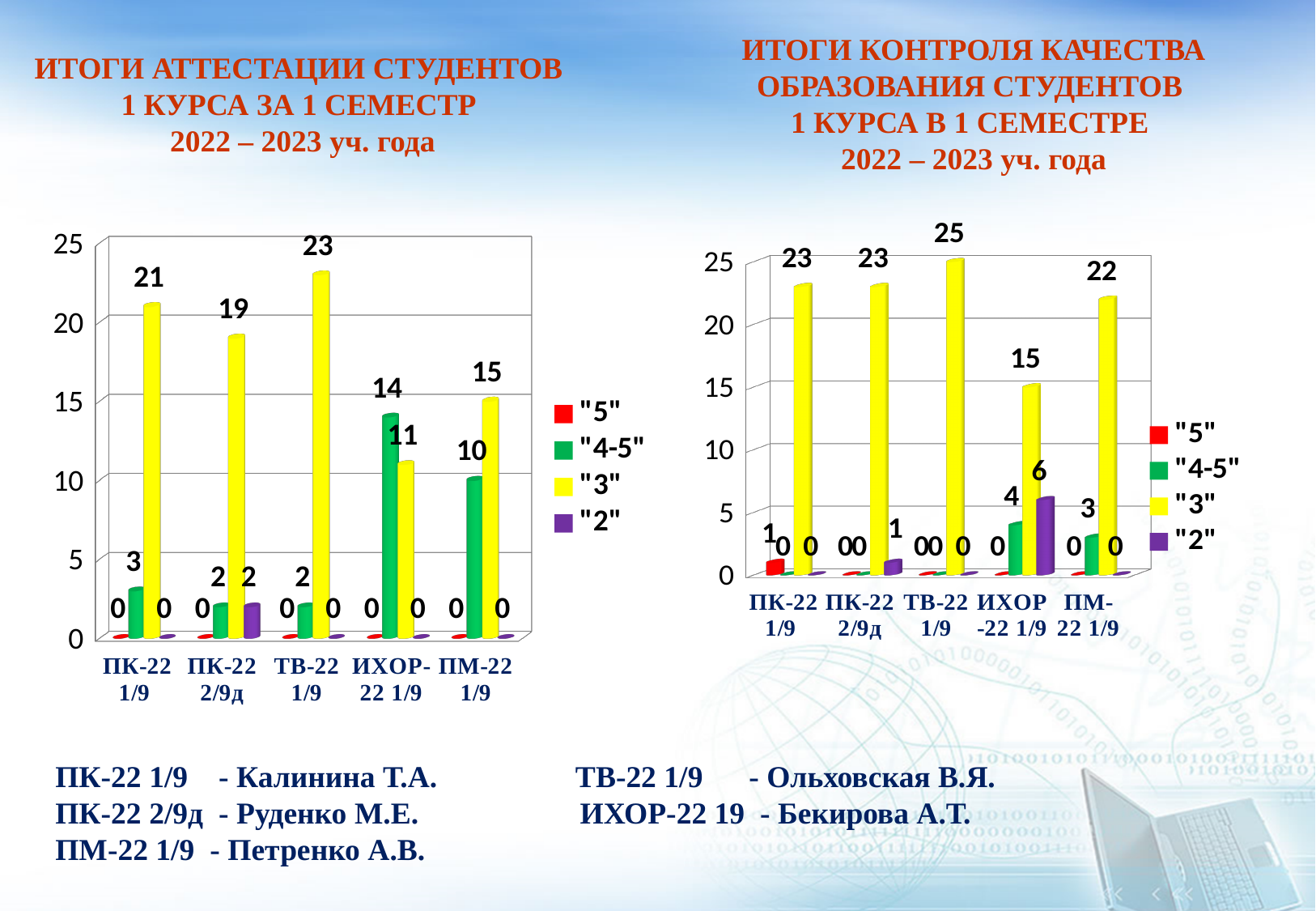
On the right chart (ИТОГИ КОНТРОЛЯ КАЧЕСТВА ОБРАЗОВАНИЯ), how many categories are shown on the x axis? 5 On the right chart (ИТОГИ КОНТРОЛЯ КАЧЕСТВА ОБРАЗОВАНИЯ), what is the difference between the "3" values for ТВ-22 1/9 and ПМ-22 1/9? 3 What kind of chart is the right chart (ИТОГИ КОНТРОЛЯ КАЧЕСТВА ОБРАЗОВАНИЯ)? Bar chart On the left chart (ИТОГИ АТТЕСТАЦИИ СТУДЕНТОВ), what is the difference between the "3" values for ПК-22 1/9 and ПК-22 2/9д? 2 On the right chart (ИТОГИ КОНТРОЛЯ КАЧЕСТВА ОБРАЗОВАНИЯ), which category has the lowest value in the "3" series? ИХОР-22 1/9 On the right chart (ИТОГИ КОНТРОЛЯ КАЧЕСТВА ОБРАЗОВАНИЯ), what is the value of the "3" series for ТВ-22 1/9? 25 On the left chart (ИТОГИ АТТЕСТАЦИИ СТУДЕНТОВ), which category has the highest value in the "3" series? ТВ-22 1/9 On the left chart (ИТОГИ АТТЕСТАЦИИ СТУДЕНТОВ), how many series does the legend list? 4 On the left chart (ИТОГИ АТТЕСТАЦИИ СТУДЕНТОВ), what is the value of the "4-5" series for ИХОР-22 1/9? 14 On the left chart (ИТОГИ АТТЕСТАЦИИ СТУДЕНТОВ), what is the value of the "3" series for ТВ-22 1/9? 23 On the right chart (ИТОГИ КОНТРОЛЯ КАЧЕСТВА ОБРАЗОВАНИЯ), what is the value of the "2" series for ИХОР-22 1/9? 6 On the left chart (ИТОГИ АТТЕСТАЦИИ СТУДЕНТОВ), which is larger for ИХОР-22 1/9: the "4-5" value or the "3" value? "4-5"